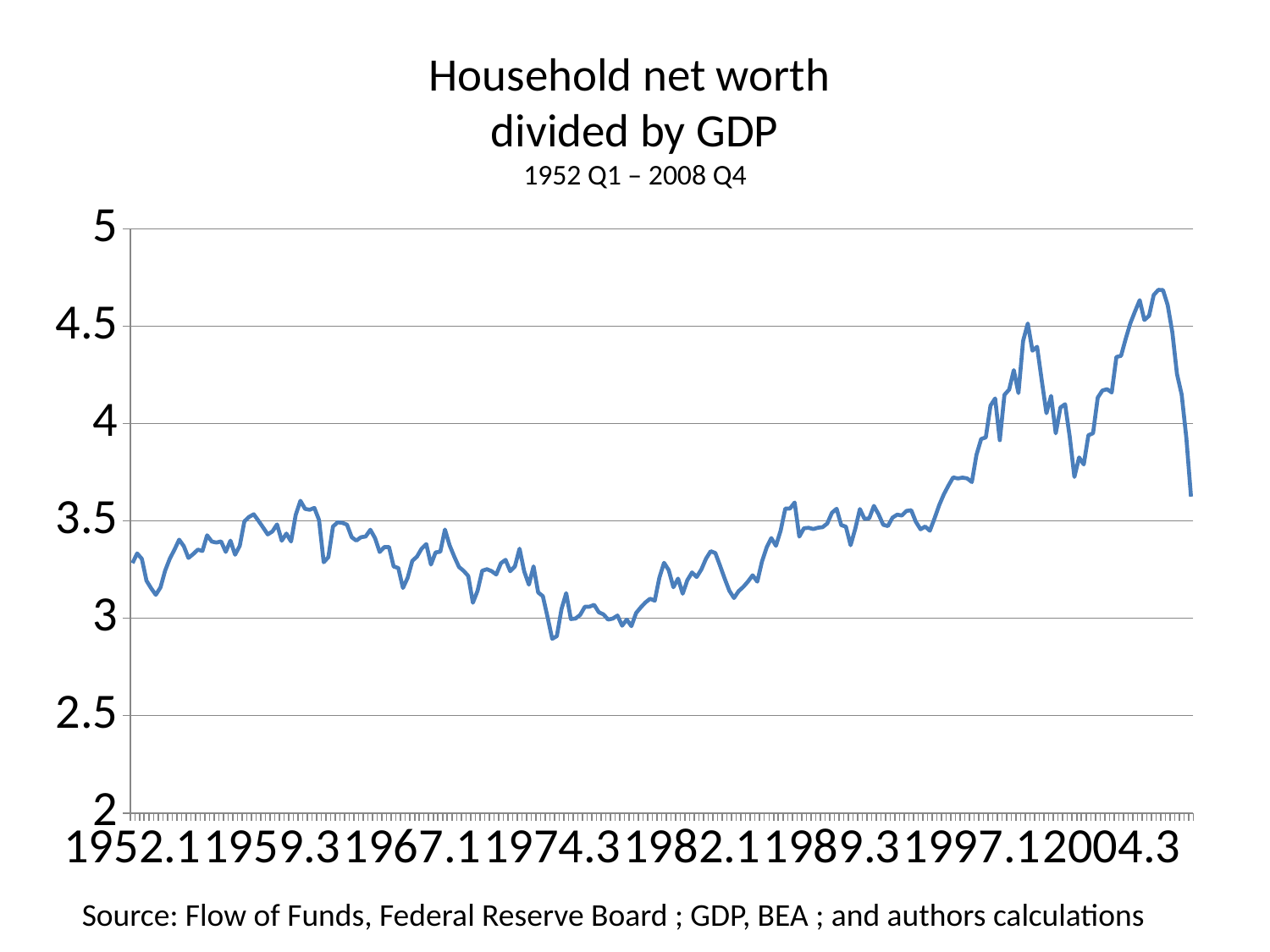
Is the value at 1989.3 greater or less than 4? less What period does the chart cover, according to its subtitle? 1952 Q1 – 2008 Q4 Is the value at 1997.1 greater or less than 3.5? greater Is the lowest value reached by the line greater or less than 3? less What kind of chart is shown on the slide? line chart What is the title of the chart? Household net worth divided by GDP Overall, does the line rise or fall from 1952 to 2008? rise